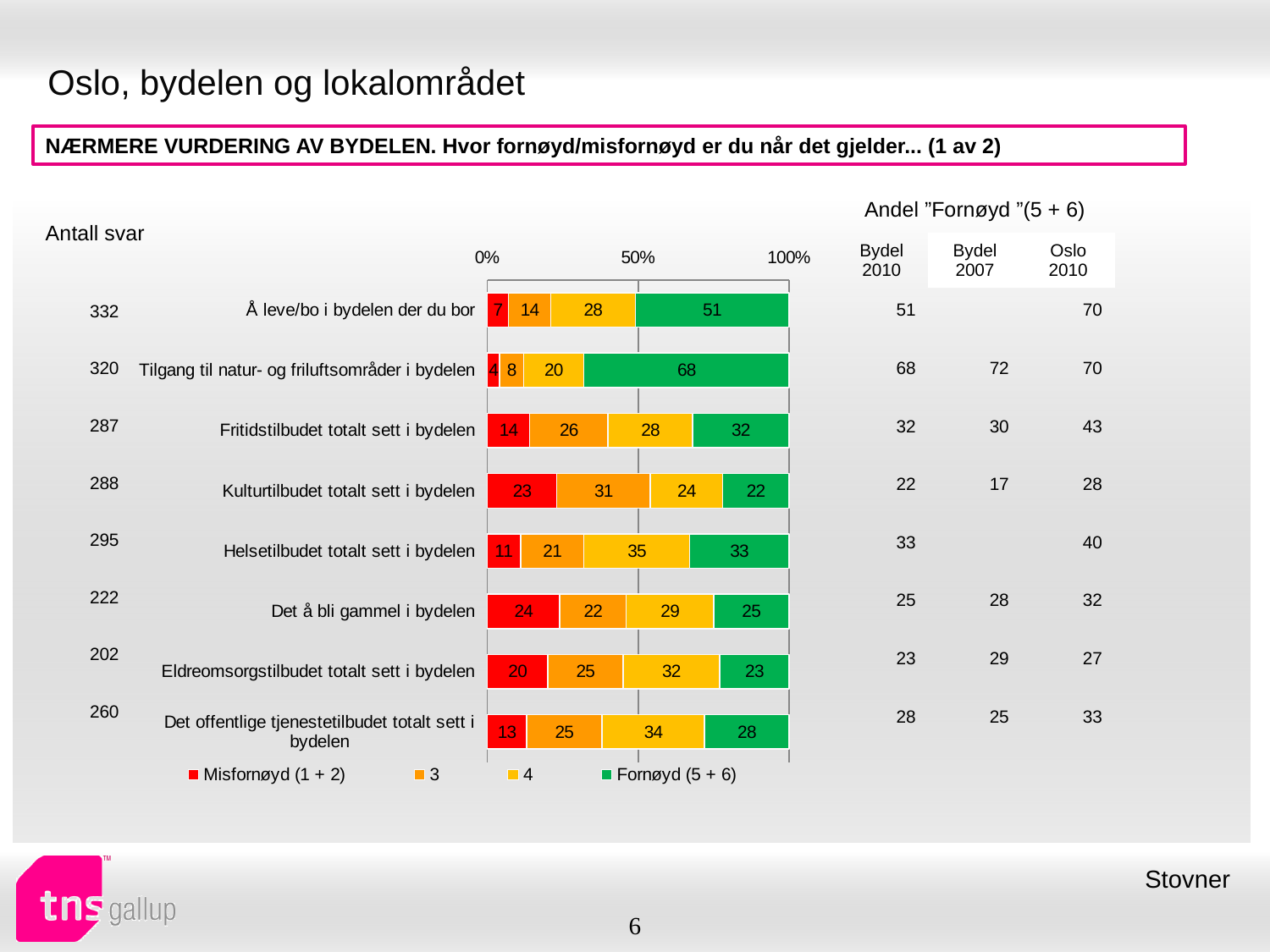
What is the 'Fornøyd (5 + 6)' value for 'Å leve/bo i bydelen der du bor'? 51 Which has a larger 'Misfornøyd (1 + 2)' value: 'Kulturtilbudet totalt sett i bydelen' or 'Eldreomsorgstilbudet totalt sett i bydelen'? Kulturtilbudet totalt sett i bydelen What is the 'Misfornøyd (1 + 2)' value for 'Det å bli gammel i bydelen'? 24 Which colour represents the 'Fornøyd (5 + 6)' series in the chart? Green What is the total of the stacked bar for 'Fritidstilbudet totalt sett i bydelen'? 100 How many series does the legend list? 4 Which category has the lowest 'Fornøyd (5 + 6)' value? Kulturtilbudet totalt sett i bydelen How many categories are shown in the chart? 8 What kind of chart is shown on the slide? Stacked bar chart What is the value of series '4' for 'Helsetilbudet totalt sett i bydelen'? 35 Which category has the highest 'Fornøyd (5 + 6)' value? Tilgang til natur- og friluftsområder i bydelen What is the difference between the 'Fornøyd (5 + 6)' values for 'Tilgang til natur- og friluftsområder i bydelen' and 'Fritidstilbudet totalt sett i bydelen'? 36